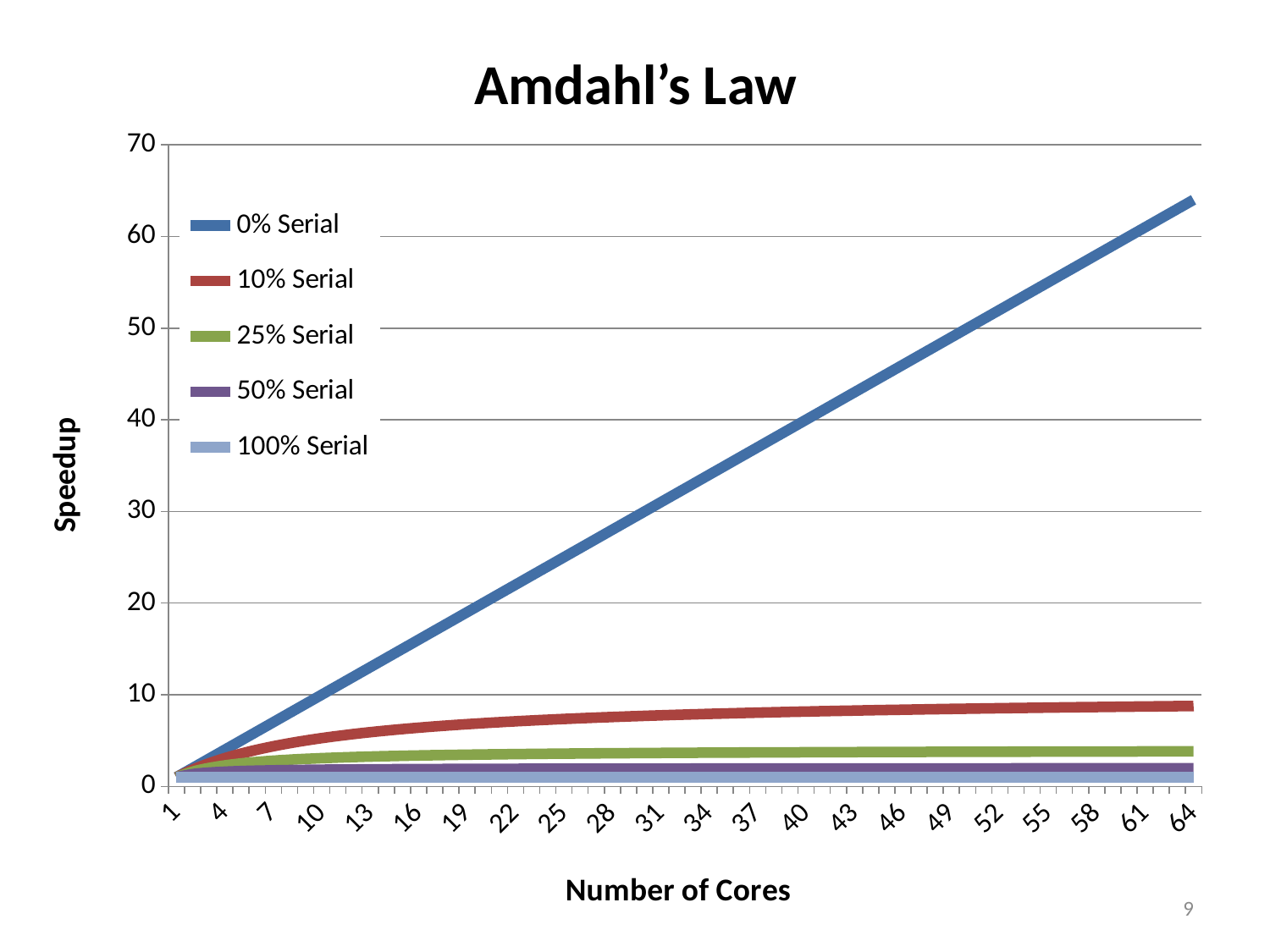
What kind of chart is shown on the slide? line chart Is the speedup for 0% Serial at 31 cores greater or less than 20? greater Is the speedup for 50% Serial at 64 cores greater or less than 10? less What is the label of the x axis? Number of Cores Is the speedup for 10% Serial at 64 cores greater or less than 10? less Does the speedup for 0% Serial rise or fall as the number of cores increases? rises At 64 cores, which series has the larger speedup, 10% Serial or 25% Serial? 10% Serial What is the title of the chart? Amdahl's Law Which series has the highest speedup at 64 cores? 0% Serial How many series does the legend list? 5 Which series has the lowest speedup at 64 cores? 100% Serial